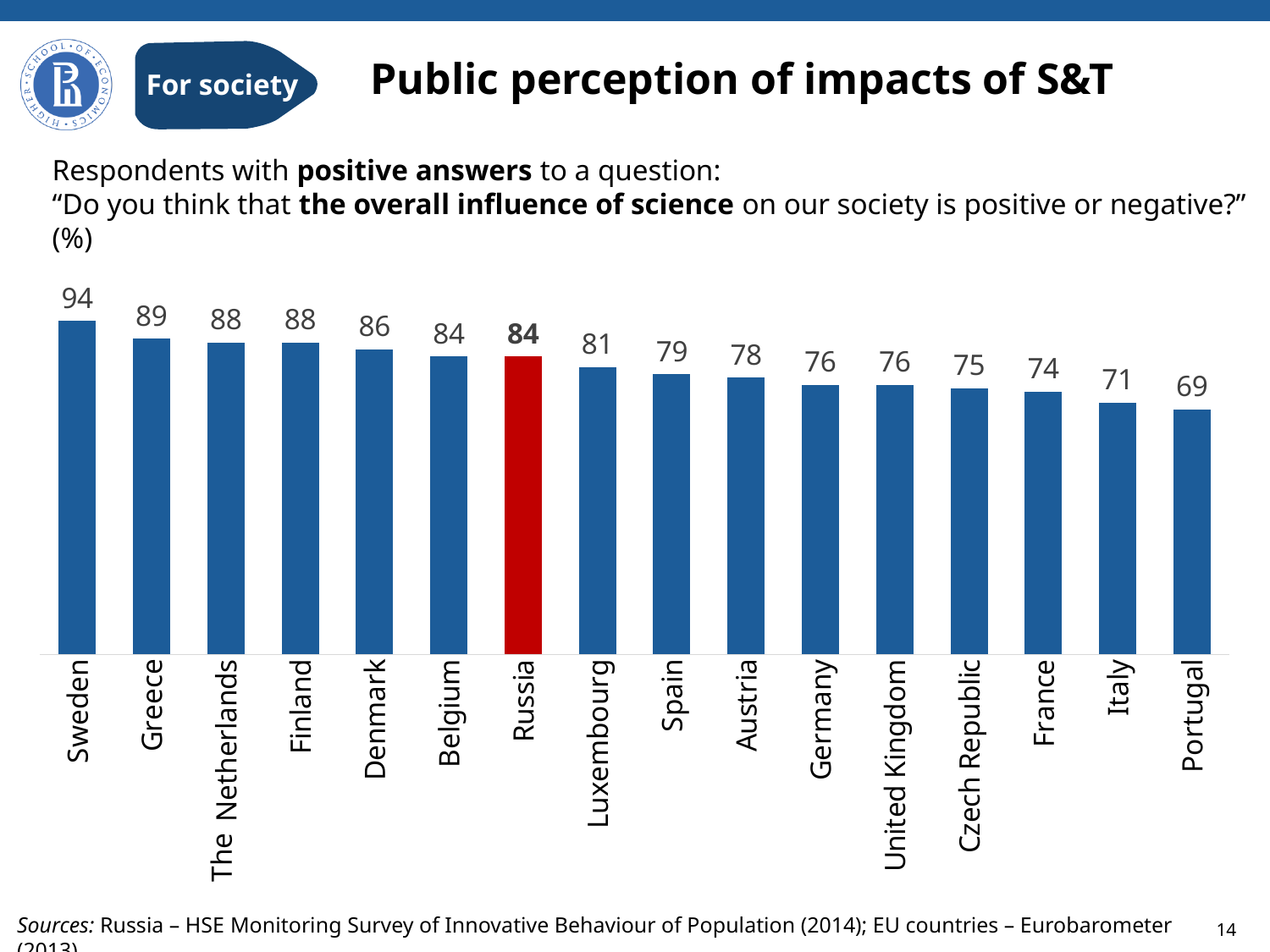
What is the value for Russia? 84 What is the difference between the values for Russia and Luxembourg? 3 Which is larger, the value for Greece or the value for Denmark? Greece What is the value for Sweden? 94 Which country has the highest value? Sweden How many countries are shown in the chart? 16 What is the difference between the values for Sweden and Portugal? 25 What is the value for Czech Republic? 75 Which country's bar is coloured red instead of blue? Russia What kind of chart is shown on the slide? Bar chart What is the value for Portugal? 69 Which country has the lowest value? Portugal